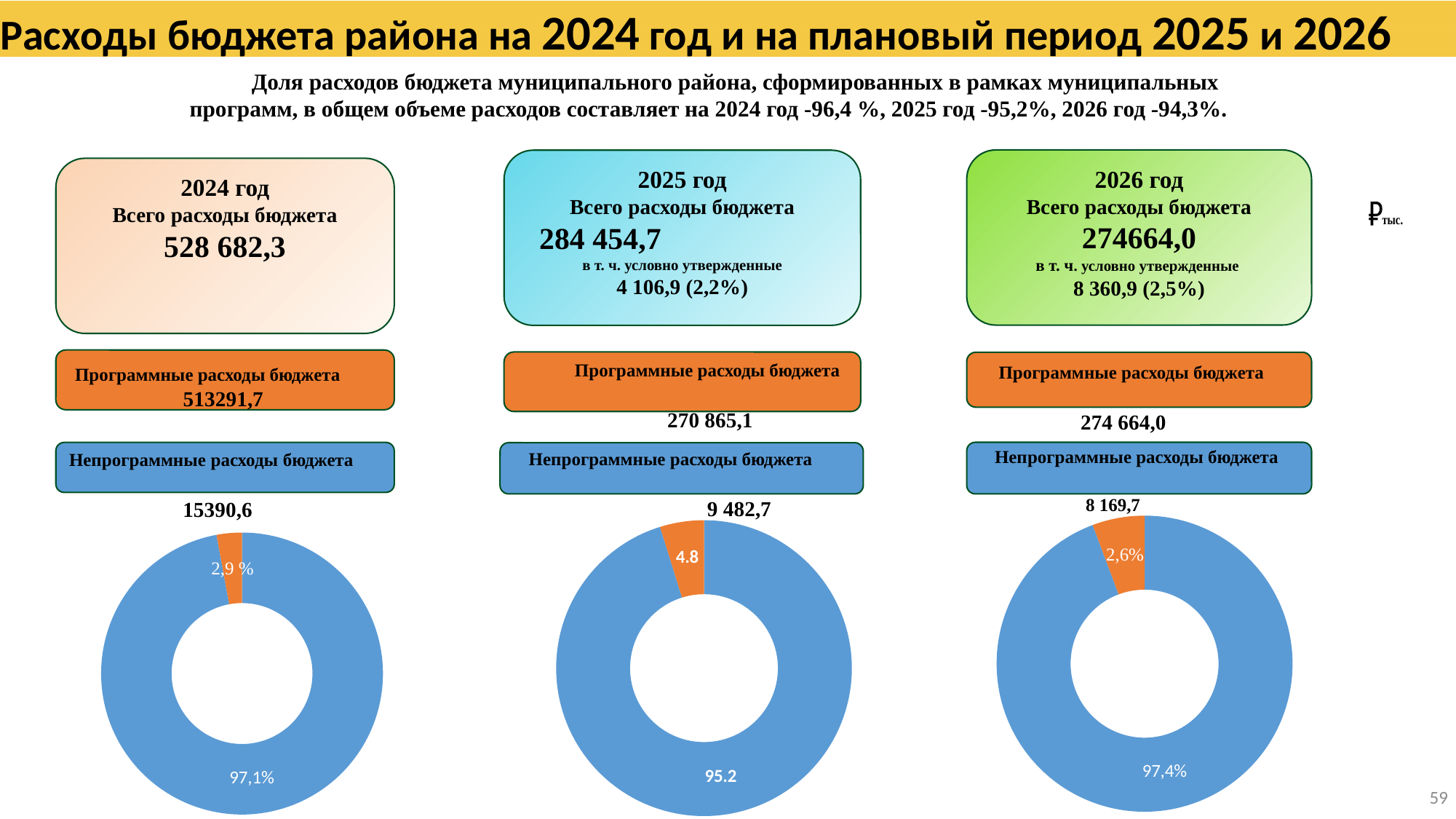
In the middle (2025) donut chart, what value is labelled on the blue slice? 95.2 How many donut charts are shown on the slide? 3 What kind of chart is used for each of the three charts at the bottom of the slide? pie chart (donut) In the middle (2025) donut chart, what value is labelled on the orange slice? 4.8 In the left (2024) donut chart, what value is labelled on the large blue slice? 97,1% In the left (2024) donut chart, what value is labelled on the small orange slice? 2,9 % In the left (2024) donut chart, what is the difference between the blue slice value and the orange slice value? 94,2 percentage points In the right (2026) donut chart, what value is labelled on the blue slice? 97,4% In the right (2026) donut chart, what value is labelled on the orange slice? 2,6% How many slices does each donut chart contain? 2